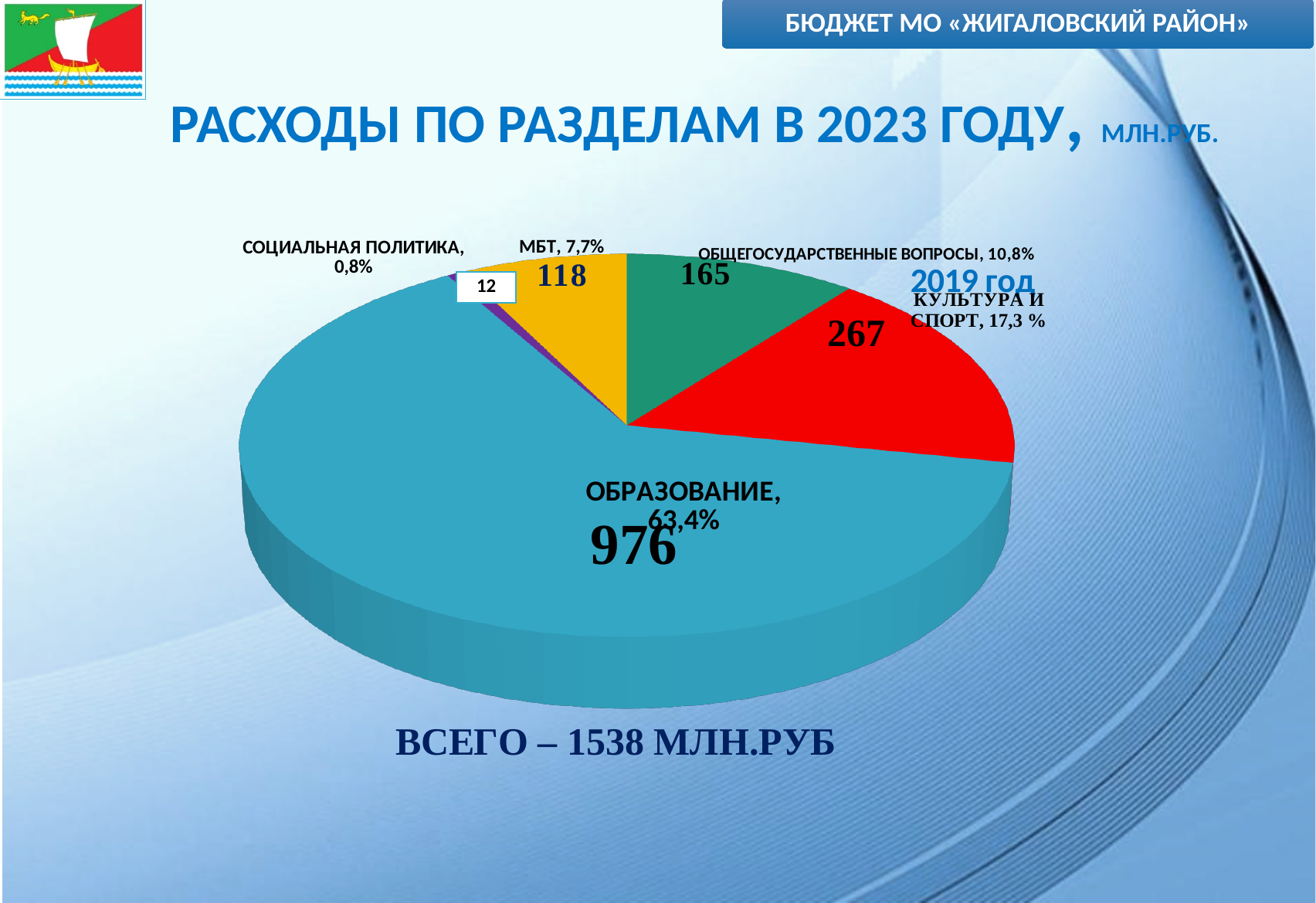
What share of the pie does ОБРАЗОВАНИЕ take? 63,4% What is the value for ОБРАЗОВАНИЕ? 976 What is the value for МБТ? 118 What kind of chart is shown on the slide? pie chart What is the value for КУЛЬТУРА И СПОРТ? 267 What share of the pie does СОЦИАЛЬНАЯ ПОЛИТИКА take? 0,8% How many categories (slices) does the pie chart show? 5 Which category has the largest slice? ОБРАЗОВАНИЕ Which category has the smallest slice? СОЦИАЛЬНАЯ ПОЛИТИКА What is the value for ОБЩЕГОСУДАРСТВЕННЫЕ ВОПРОСЫ? 165 Which is larger, the value for МБТ or the value for ОБЩЕГОСУДАРСТВЕННЫЕ ВОПРОСЫ? ОБЩЕГОСУДАРСТВЕННЫЕ ВОПРОСЫ What is the difference between the values for КУЛЬТУРА И СПОРТ and ОБЩЕГОСУДАРСТВЕННЫЕ ВОПРОСЫ? 102